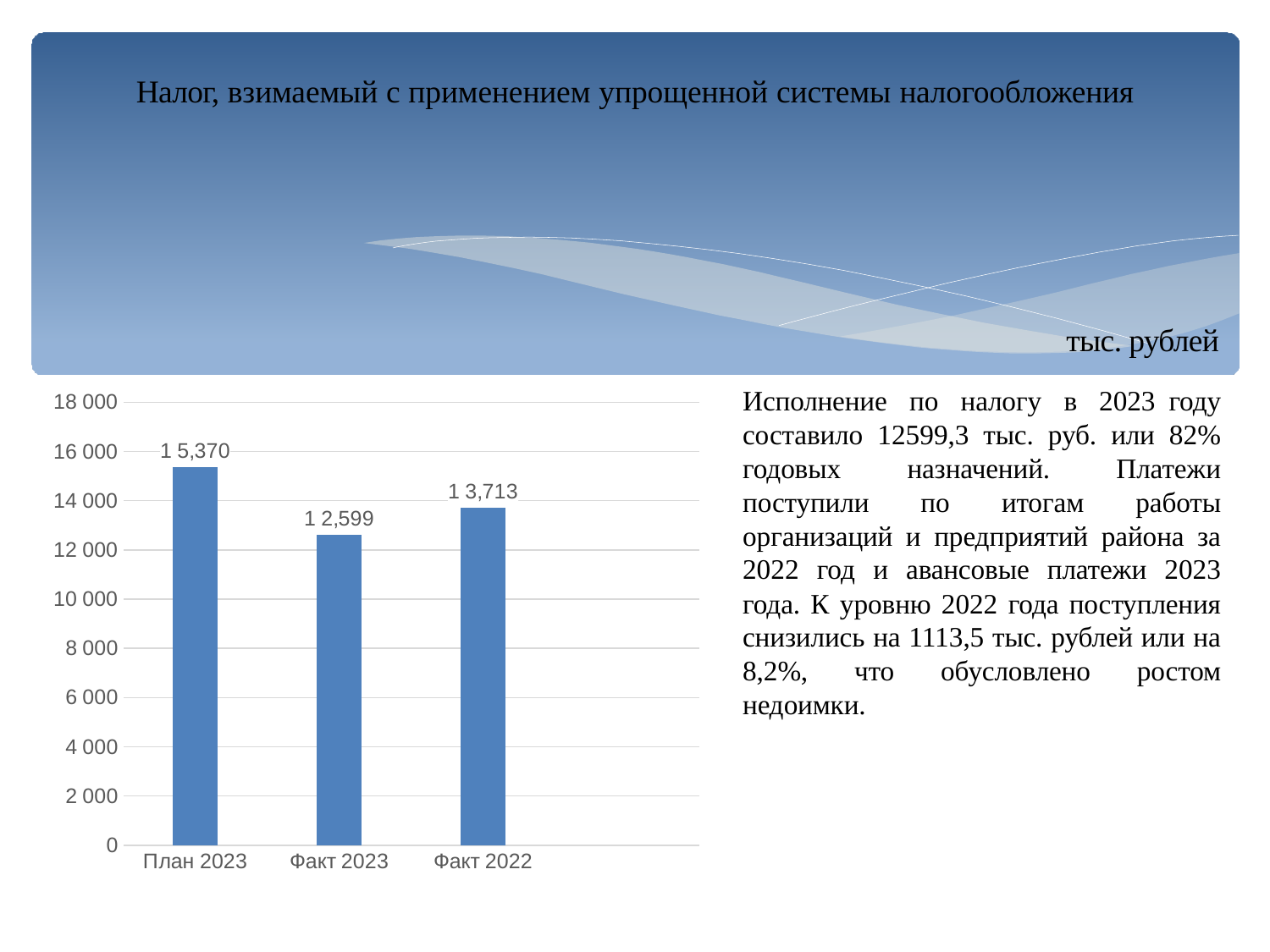
Which category has the lowest value? Факт 2023 What is the value for План 2023? 15,370 What is the difference between Факт 2022 and Факт 2023? 1,114 How many categories are shown on the chart? 3 Is the value for Факт 2023 greater or less than 14 000? less What is the value for Факт 2022? 13,713 What unit is stated for the chart values? тыс. рублей Which category has the highest value? План 2023 What is the value for Факт 2023? 12,599 Which is larger, Факт 2022 or Факт 2023? Факт 2022 What is the difference between План 2023 and Факт 2023? 2,771 What kind of chart is shown on the slide? bar chart